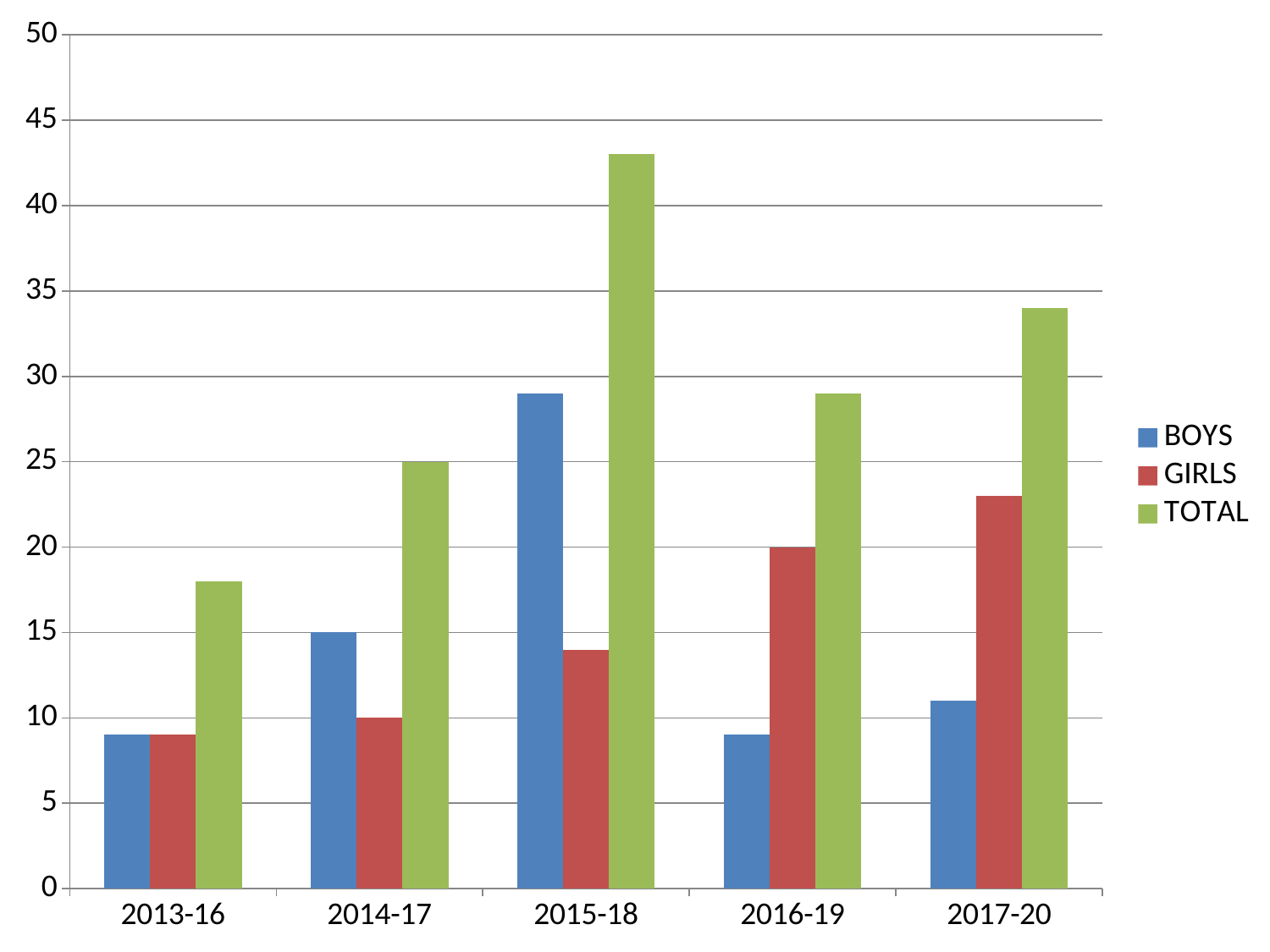
Is the value for BOYS in 2017-20 greater or less than 15? less Which category has the highest TOTAL value? 2015-18 How many categories are shown on the x axis? 5 Which category has the lowest TOTAL value? 2013-16 What is the value for TOTAL in 2014-17? 25 How many series does the legend list? 3 Which is larger in 2015-18, BOYS or GIRLS? BOYS What is the value for BOYS in 2014-17? 15 What is the value for GIRLS in 2016-19? 20 What kind of chart is shown on the slide? bar chart Is the value for TOTAL in 2015-18 greater or less than 40? greater What is the value for GIRLS in 2014-17? 10